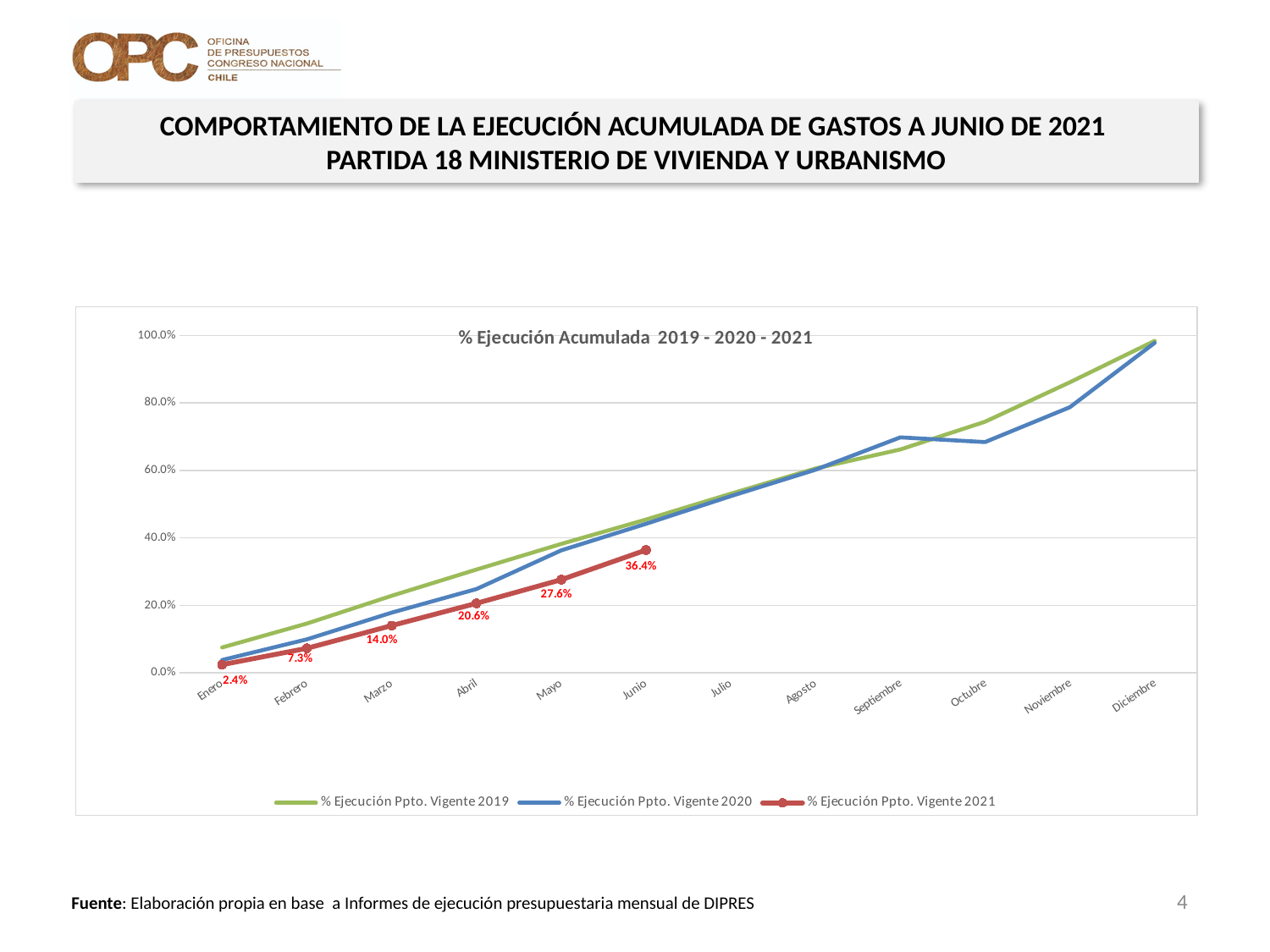
What is the value for % Ejecución Ppto. Vigente 2021 in Marzo? 14.0% In which month is the % Ejecución Ppto. Vigente 2021 series lowest? Enero What kind of chart is shown on the slide? line chart In Noviembre, which series has the larger value: % Ejecución Ppto. Vigente 2019 or % Ejecución Ppto. Vigente 2020? % Ejecución Ppto. Vigente 2019 Is the value for % Ejecución Ppto. Vigente 2020 in Septiembre greater or less than 60.0%? greater What is the value for % Ejecución Ppto. Vigente 2021 in Enero? 2.4% How many series does the legend list? 3 In which month is the % Ejecución Ppto. Vigente 2021 series highest? Junio What is the value for % Ejecución Ppto. Vigente 2021 in Abril? 20.6% What is the value for % Ejecución Ppto. Vigente 2021 in Junio? 36.4% Do the values of the % Ejecución Ppto. Vigente 2021 series rise or fall from Enero to Junio? rise What is the difference between the 2021 values for Junio and Mayo? 8.8%